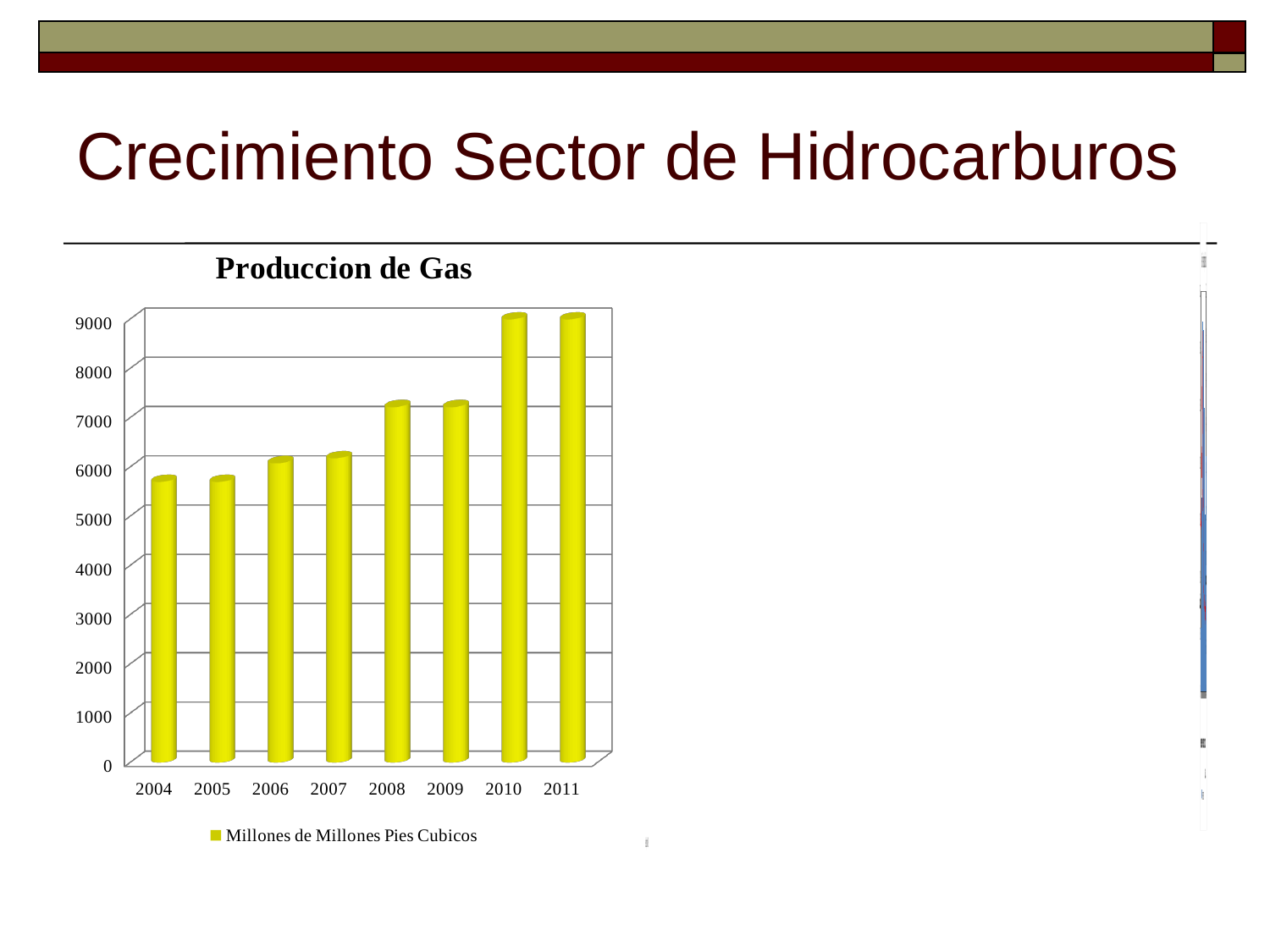
What is the title of the chart on the slide? Produccion de Gas Is the value for 2010 in the "Produccion de Gas" chart greater or less than 8000? greater Is the value for 2008 in the "Produccion de Gas" chart greater or less than 7000? greater What kind of chart is shown under the title "Produccion de Gas"? bar chart How many series does the legend of the "Produccion de Gas" chart list? 1 How many years are shown on the x axis of the "Produccion de Gas" chart? 8 Is the value for 2005 in the "Produccion de Gas" chart greater or less than 6000? less Do the values in the "Produccion de Gas" chart generally rise or fall from 2004 to 2011? rise What is the legend entry of the "Produccion de Gas" chart? Millones de Millones Pies Cubicos In the "Produccion de Gas" chart, which year has the larger value, 2005 or 2008? 2008